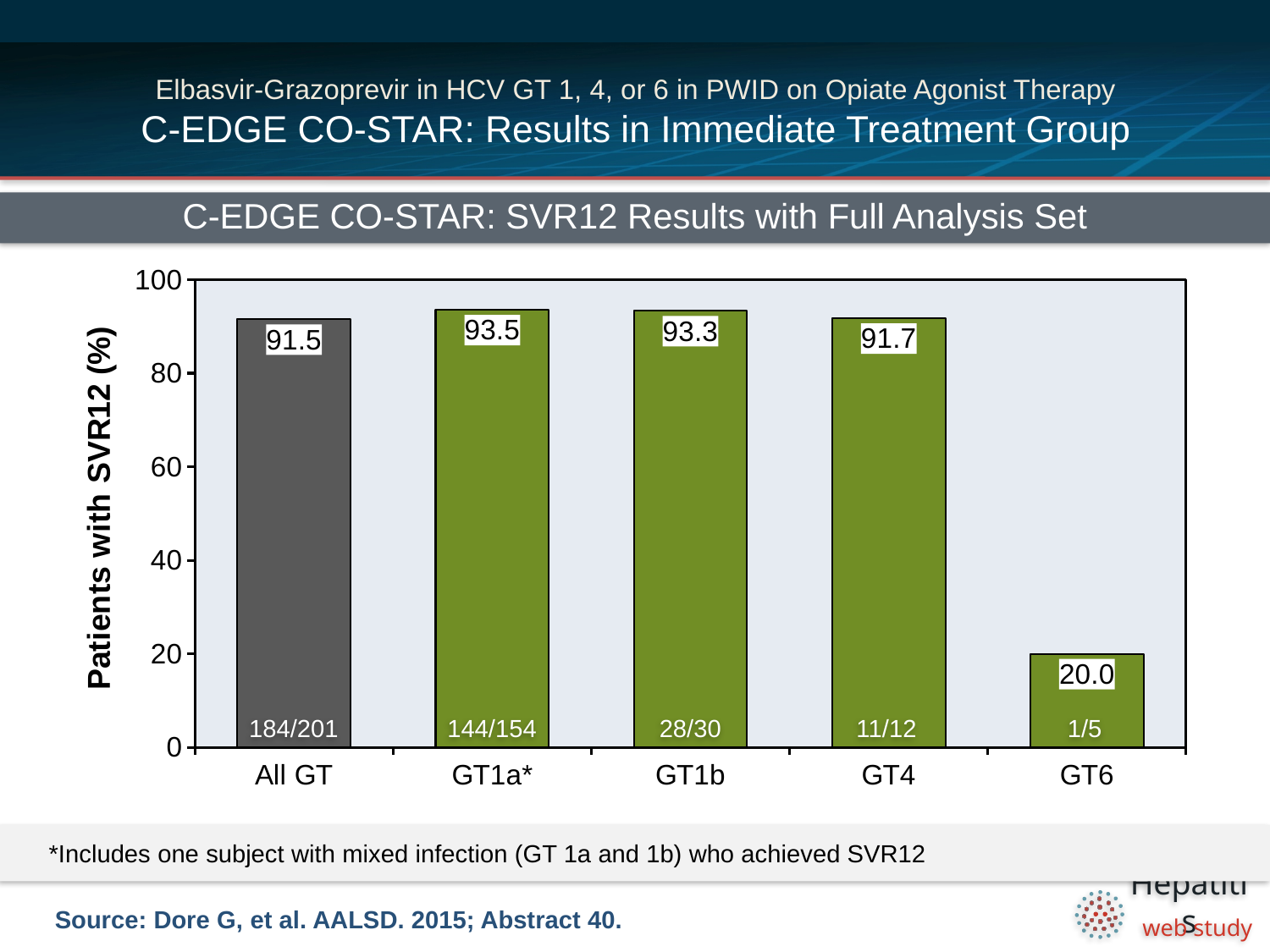
Which category has the lowest SVR12 rate? GT6 What kind of chart is shown? bar chart What is the y-axis label of the chart? Patients with SVR12 (%) Which category has the highest SVR12 rate? GT1a* What is the SVR12 rate for GT1b? 93.3 Is the value for GT6 greater or less than 40? less What is the SVR12 rate for All GT? 91.5 What fraction of patients is shown inside the GT4 bar? 11/12 What is the difference between the SVR12 rates for GT1a* and GT6? 73.5 How many categories are shown on the x axis? 5 What is the title of the chart? C-EDGE CO-STAR: SVR12 Results with Full Analysis Set Which has a higher SVR12 rate, GT4 or GT1b? GT1b